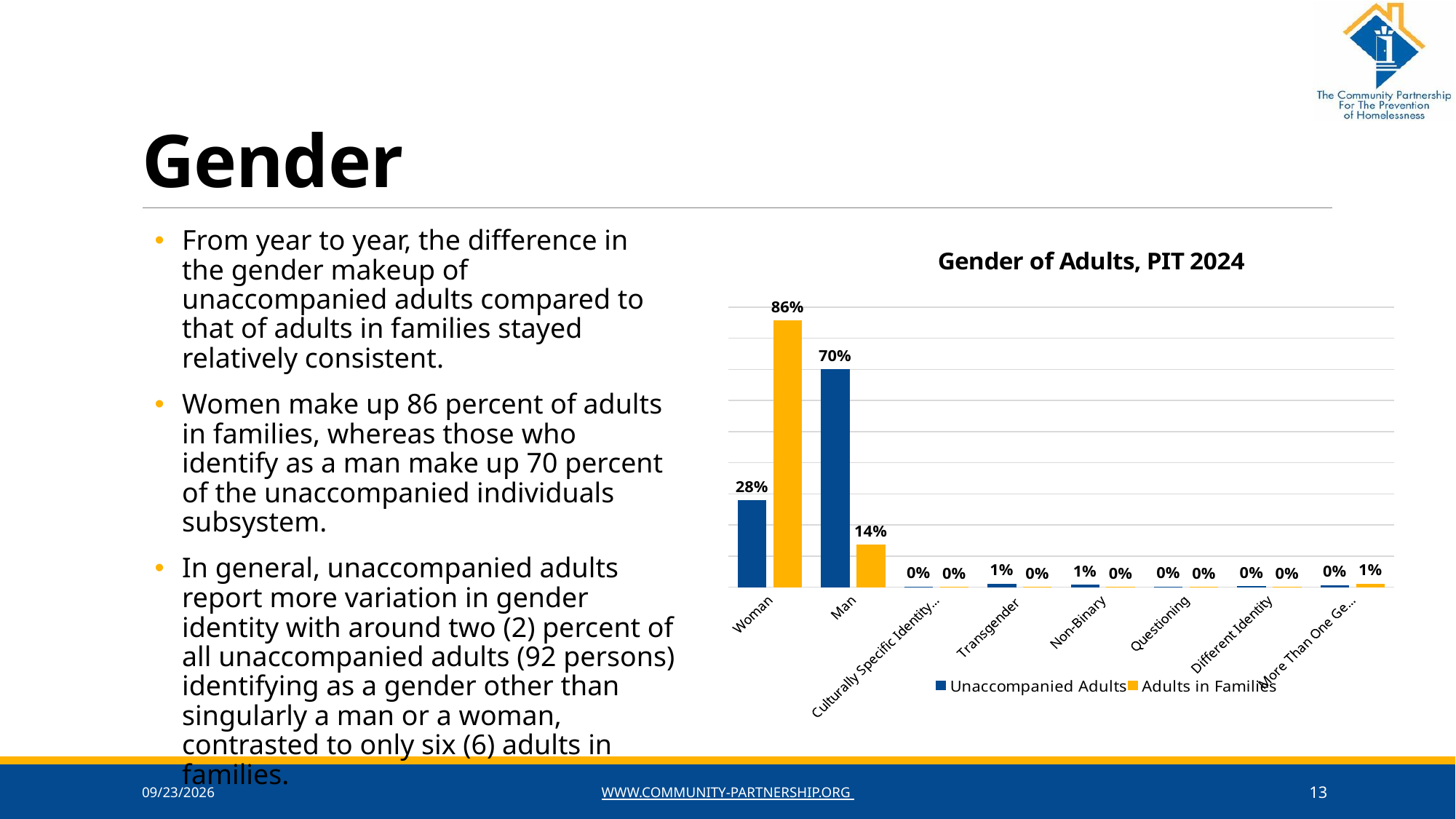
What is the difference between the Adults in Families and Unaccompanied Adults values for Woman? 58% What is the value for Man in the Unaccompanied Adults series? 70% How many series does the chart's legend list? 2 What is the value for Woman in the Unaccompanied Adults series? 28% What type of chart is shown on the slide? Bar chart What is the value for Man in the Adults in Families series? 14% Which is larger for Man: the Unaccompanied Adults value or the Adults in Families value? Unaccompanied Adults Which category has the highest value in the Unaccompanied Adults series? Man What is the value for Transgender in the Unaccompanied Adults series? 1% What is the value for Woman in the Adults in Families series? 86% How many categories are shown on the x axis of the chart? 8 Which category has the highest value in the Adults in Families series? Woman